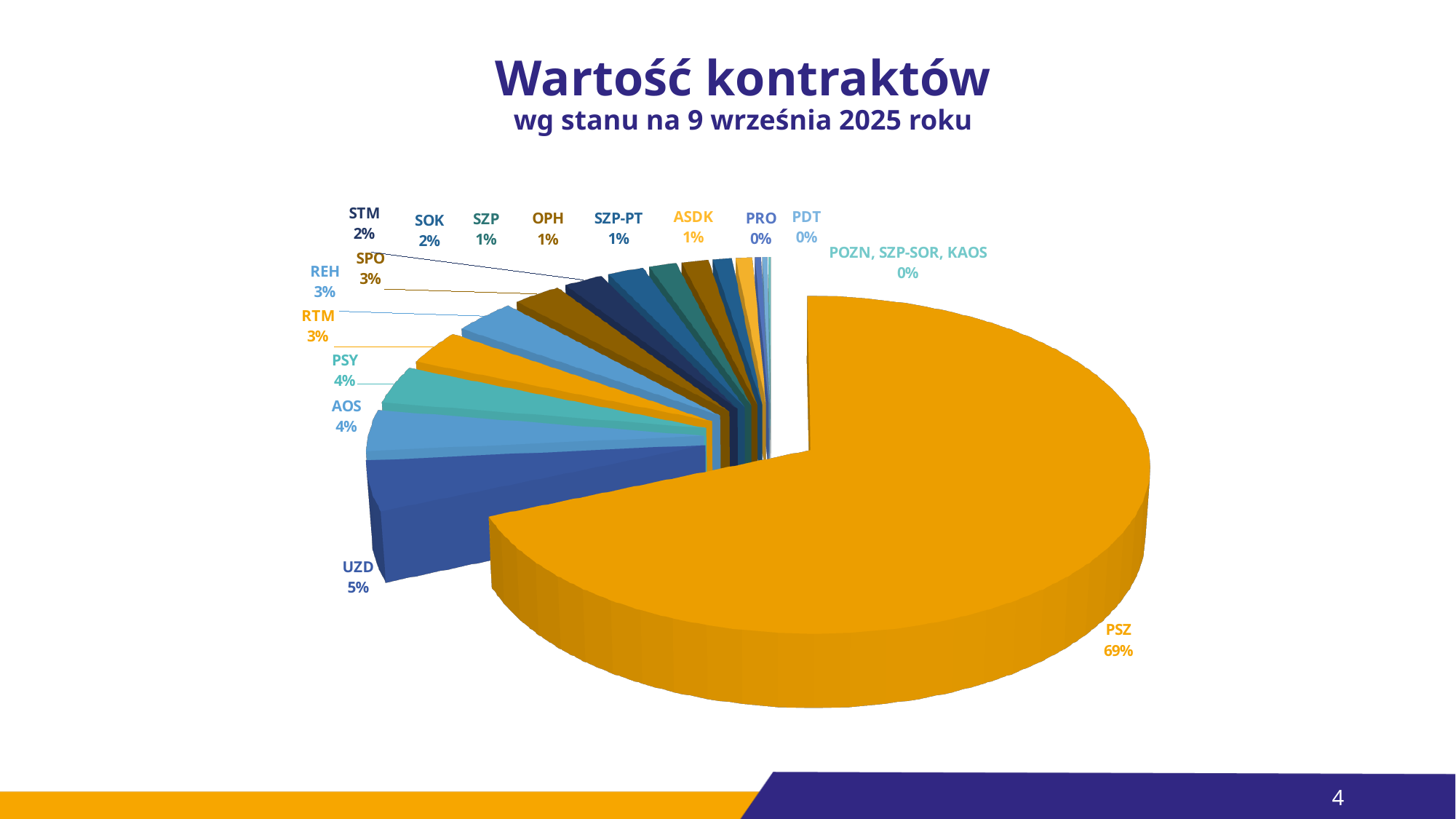
What is the value shown for RTM? 3% Which is larger, the share for UZD or the share for STM? UZD What share of the pie does PSZ hold? 69% What is the value shown for SZP-PT? 1% What is the value shown for AOS? 4% Which category has the largest slice of the pie? PSZ What is the value shown for UZD? 5% What is the difference in percentage points between PSZ and UZD? 64 What kind of chart is shown on the slide? pie chart What is the value shown for STM? 2% What is the title of the chart on the slide? Wartość kontraktów What is the difference in percentage points between UZD and SOK? 3